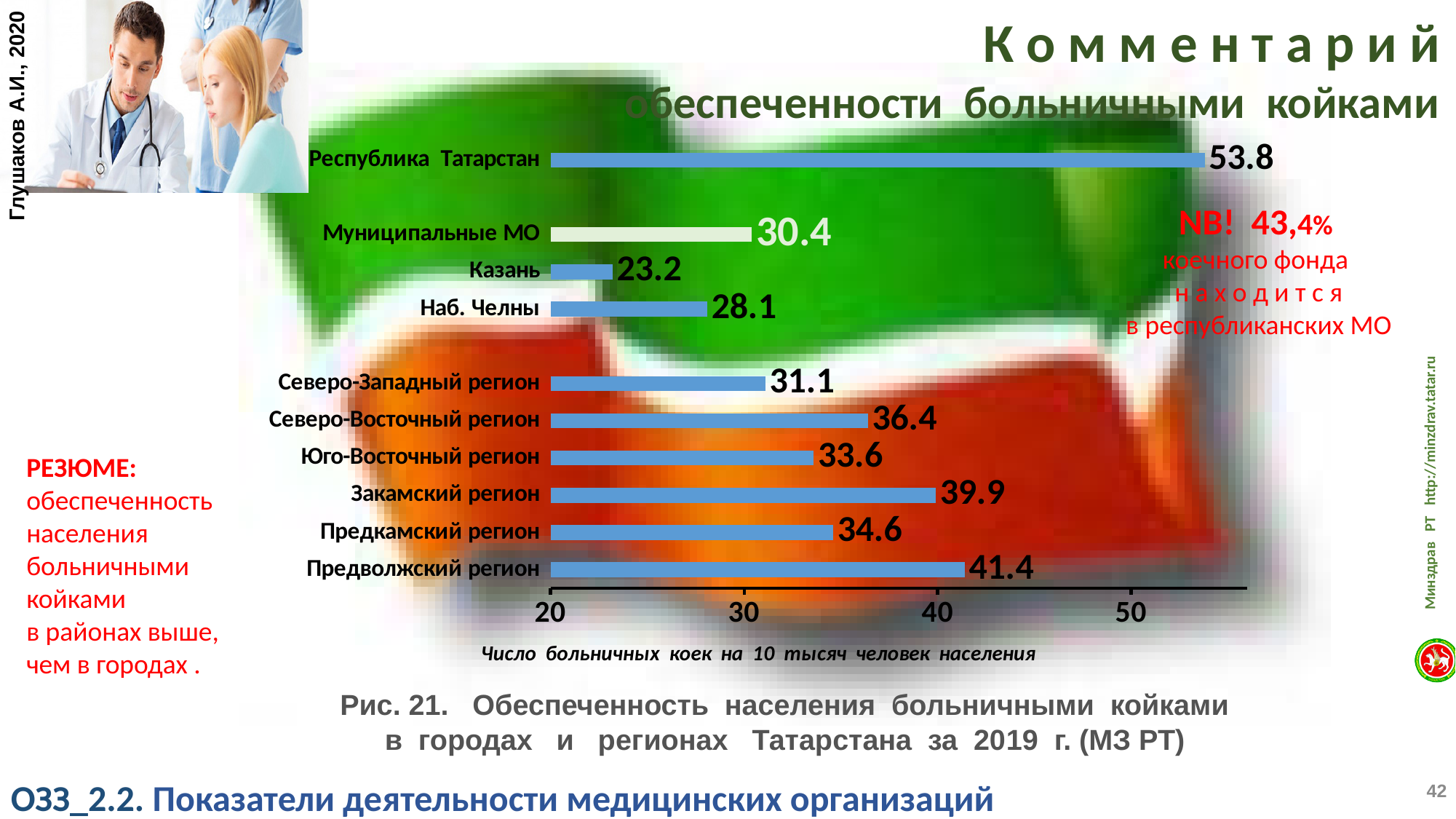
What is the difference between the values for Муниципальные МО and Казань? 7.2 What is the value for Закамский регион? 39.9 Which is larger, the value for Северо-Восточный регион or the value for Юго-Восточный регион? Северо-Восточный регион What kind of chart is shown on the slide? Bar chart What is the value for Республика Татарстан? 53.8 What is the label of the horizontal axis of the chart? Число больничных коек на 10 тысяч человек населения Which category has the highest value? Республика Татарстан What is the value for Наб. Челны? 28.1 What is the value for Казань? 23.2 How many categories are shown in the chart? 10 Which category has the lowest value? Казань What is the difference between the values for Предволжский регион and Северо-Западный регион? 10.3